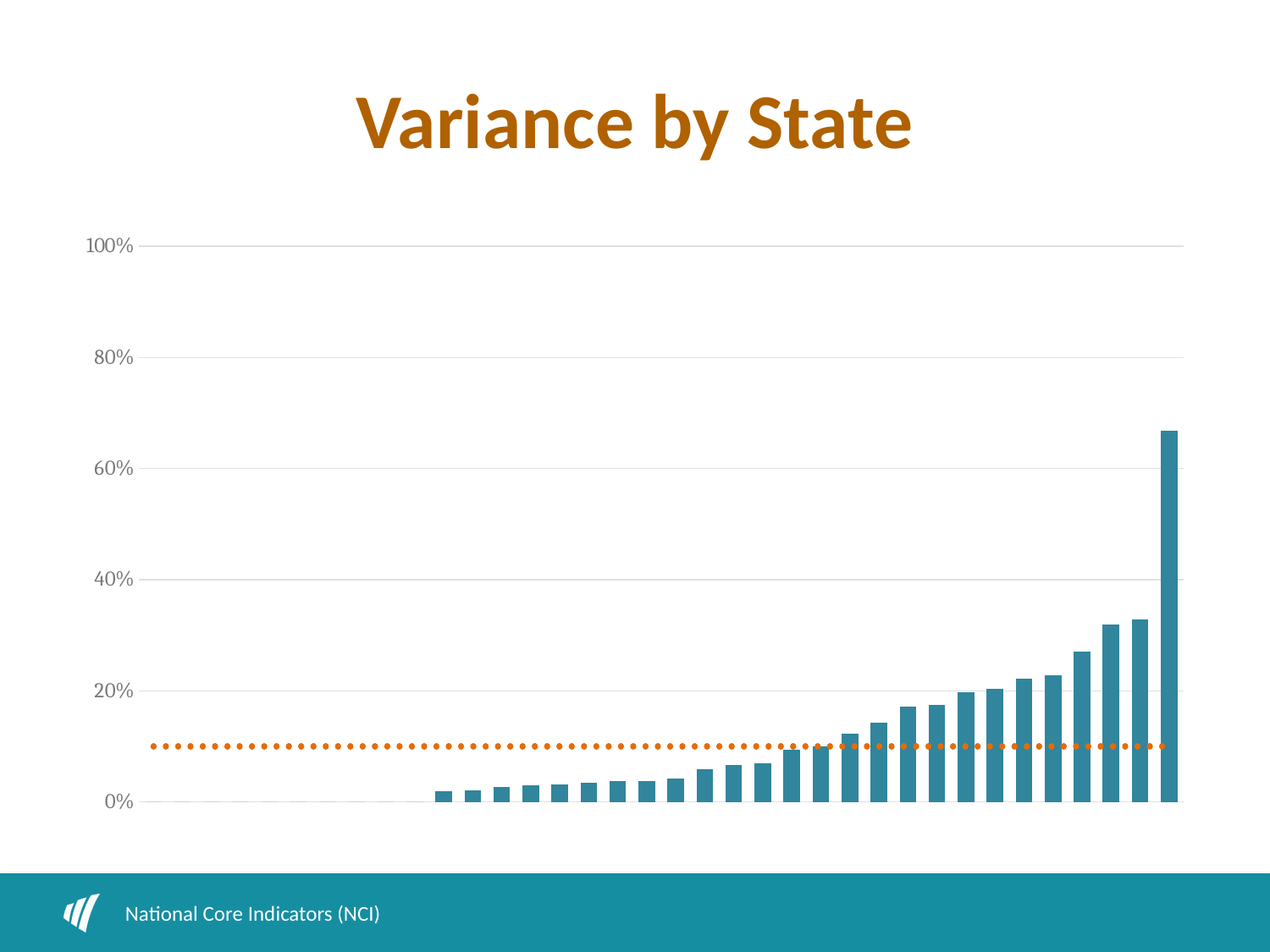
Do the bar values rise or fall from left to right along the x axis? rise Is the level of the orange dotted horizontal line greater or less than 20%? less Is the value of the leftmost visible bar greater or less than 20%? less Is the value of the tallest bar greater or less than 60%? greater What is the highest value shown on the y axis? 100% Which bar is the highest: the leftmost bar or the rightmost bar? the rightmost bar What kind of chart is shown on the slide? bar chart What is the title of the chart? Variance by State